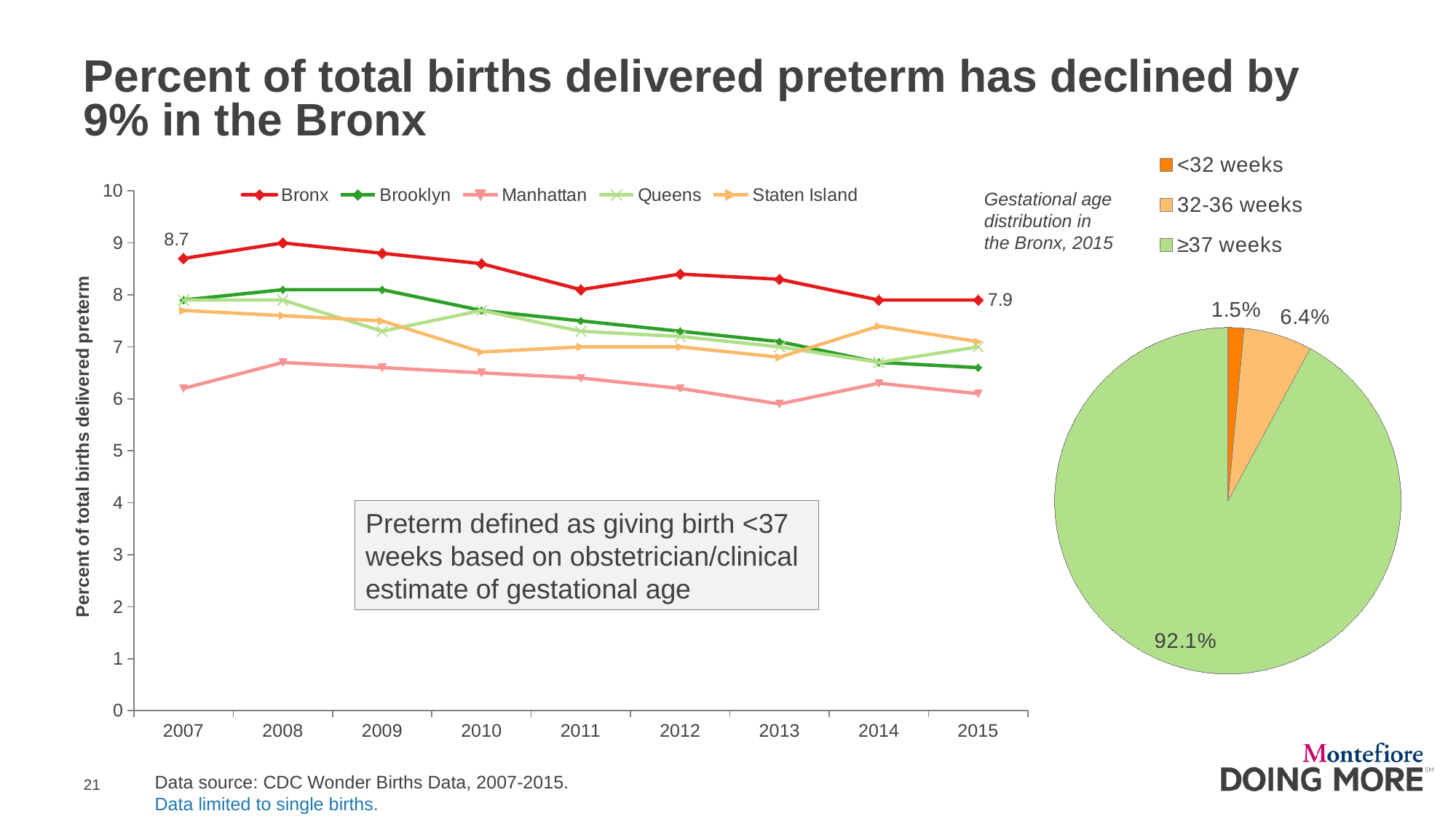
In the line chart, what was the percent of total births delivered preterm in the Bronx in 2007? 8.7 How many boroughs are listed in the legend of the line chart? 5 In the line chart, by how much did the Bronx value fall from 2007 to 2015? 0.8 In the pie chart of gestational age distribution in the Bronx, 2015, which category has the smallest slice? <32 weeks In the pie chart of gestational age distribution in the Bronx, 2015, what share of births were at 32-36 weeks? 6.4% How many years are shown on the x axis of the line chart? 9 In the line chart, what was the percent of total births delivered preterm in the Bronx in 2015? 7.9 In the line chart, is the value for Manhattan in 2007 greater or less than 7? less In the line chart, which borough has the lowest percent of preterm births in 2015? Manhattan What kind of chart is the chart on the left of the slide? Line chart In the line chart, does the Bronx line generally rise or fall from 2007 to 2015? Fall In the line chart, which borough has the highest percent of preterm births in 2015? Bronx